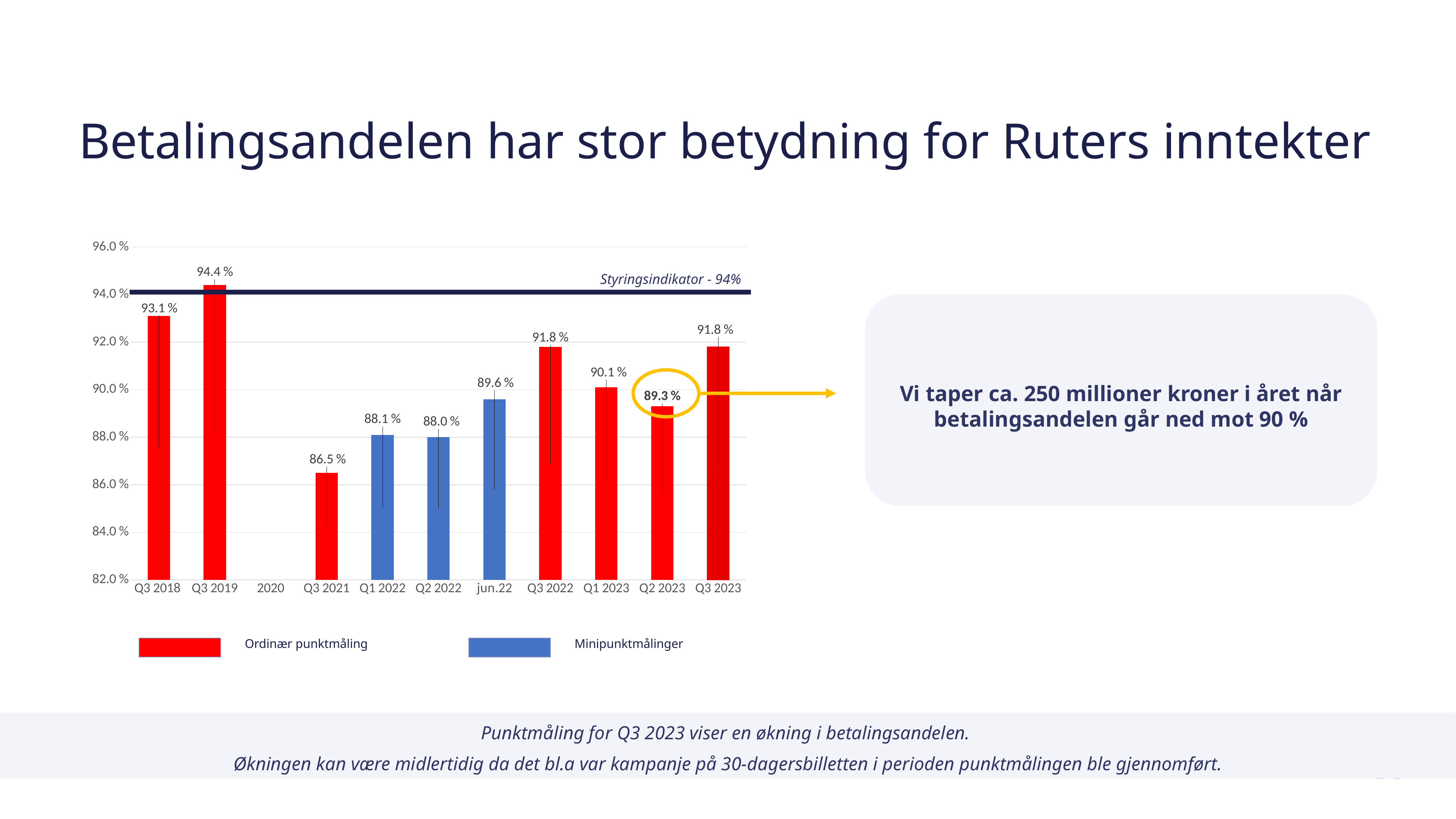
What is the value for Q2 2023? 89.3 % What is the value for Q3 2019? 94.4 % How many series does the legend list? 2 What is the value for jun.22? 89.6 % What is the value for Q3 2021? 86.5 % What kind of chart is shown on the slide? bar chart Is the value for Q3 2018 greater or less than 94.0 %? less Which is larger, the value for Q1 2023 or the value for Q2 2023? Q1 2023 What is the difference between the values for Q3 2019 and Q3 2021? 7.9 % How many bars are plotted in the chart? 10 Which category has the lowest value? Q3 2021 Which category has the highest value? Q3 2019